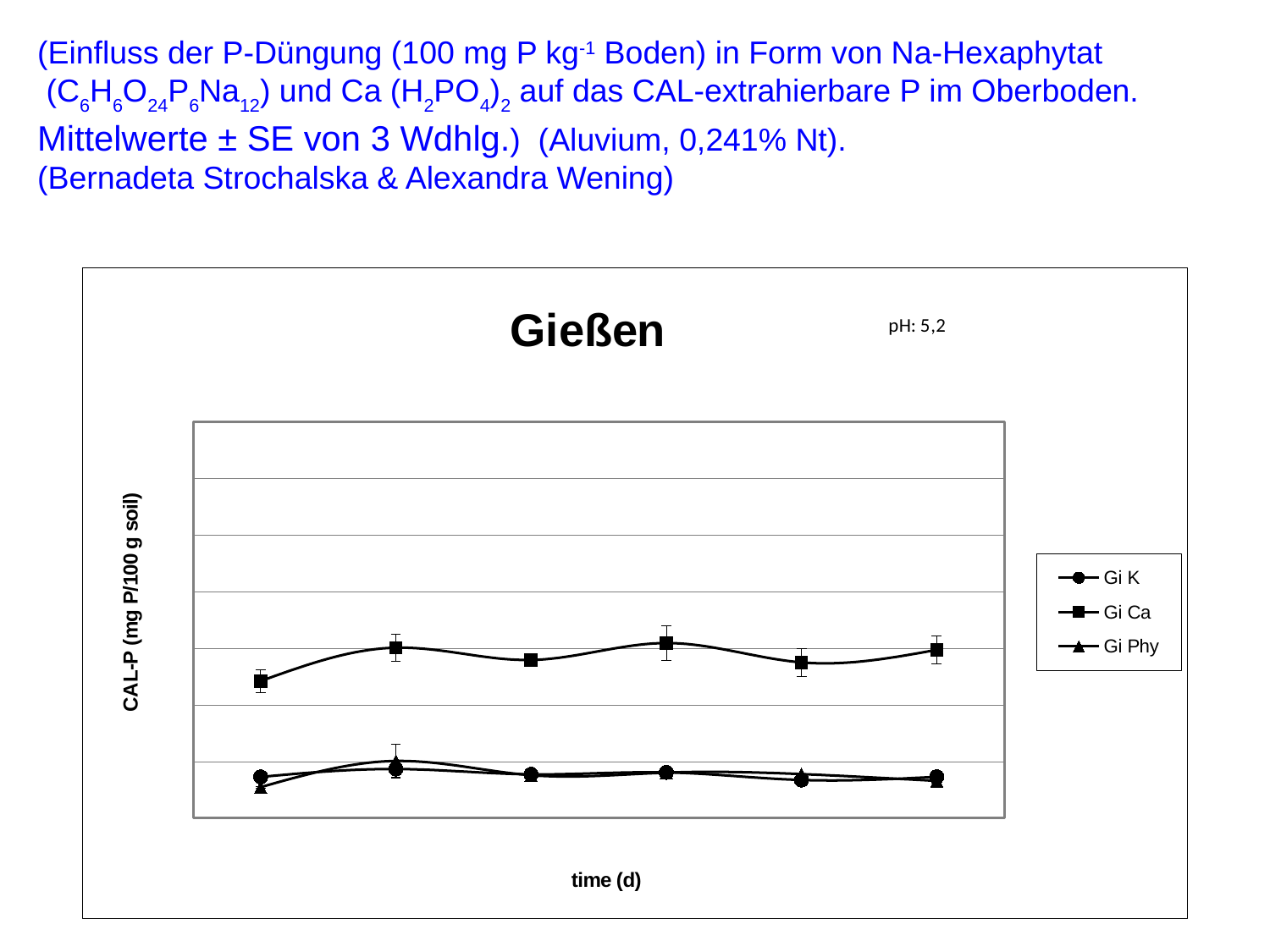
Does the Gi Ca series rise or fall between the first and second time points? rise What is the title of the chart? Gießen What are the series names listed in the legend? Gi K, Gi Ca, Gi Phy Does the Gi Ca series rise or fall between the fourth and fifth time points? fall How many data points are plotted for the Gi Ca series? 6 At the first time point, which is larger: the value for Gi Ca or the value for Gi K? Gi Ca How many series does the legend list? 3 Which series has the highest values throughout the chart? Gi Ca At the last time point, which is larger: the value for Gi Ca or the value for Gi Phy? Gi Ca What kind of chart is shown on the slide? line chart